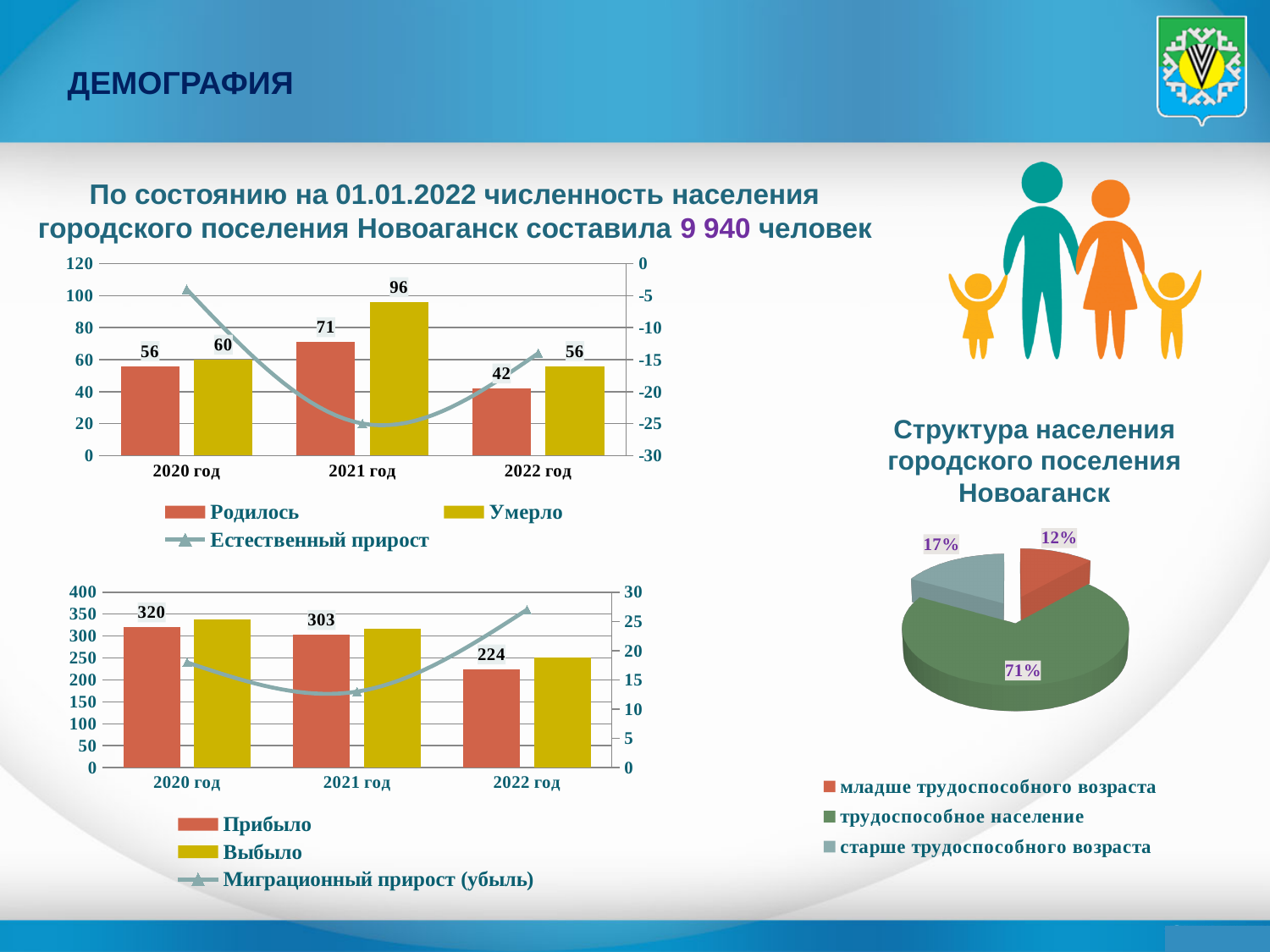
In the top-left chart, what is the value of Умерло for 2022 год? 56 In the top-left chart, how many series does the legend list? 3 In the top-left chart, in which year is Умерло highest? 2021 год In the bottom-left chart, what is the value of Прибыло for 2020 год? 320 In the bottom-left chart, does Прибыло rise or fall from 2020 год to 2022 год? fall In the top-left chart, what is the value of Родилось for 2021 год? 71 In the top-left chart, what is the difference between Умерло and Родилось in 2021 год? 25 In the bottom-left chart, what is the difference between Прибыло in 2020 год and 2022 год? 96 In the bottom-left chart, is the value of Выбыло for 2022 год greater or less than 300? less In the pie chart Структура населения городского поселения Новоаганск, what share is трудоспособное население? 71% In the pie chart Структура населения городского поселения Новоаганск, which category has the smallest share? младше трудоспособного возраста In the top-left chart, in which year is Родилось lowest? 2022 год